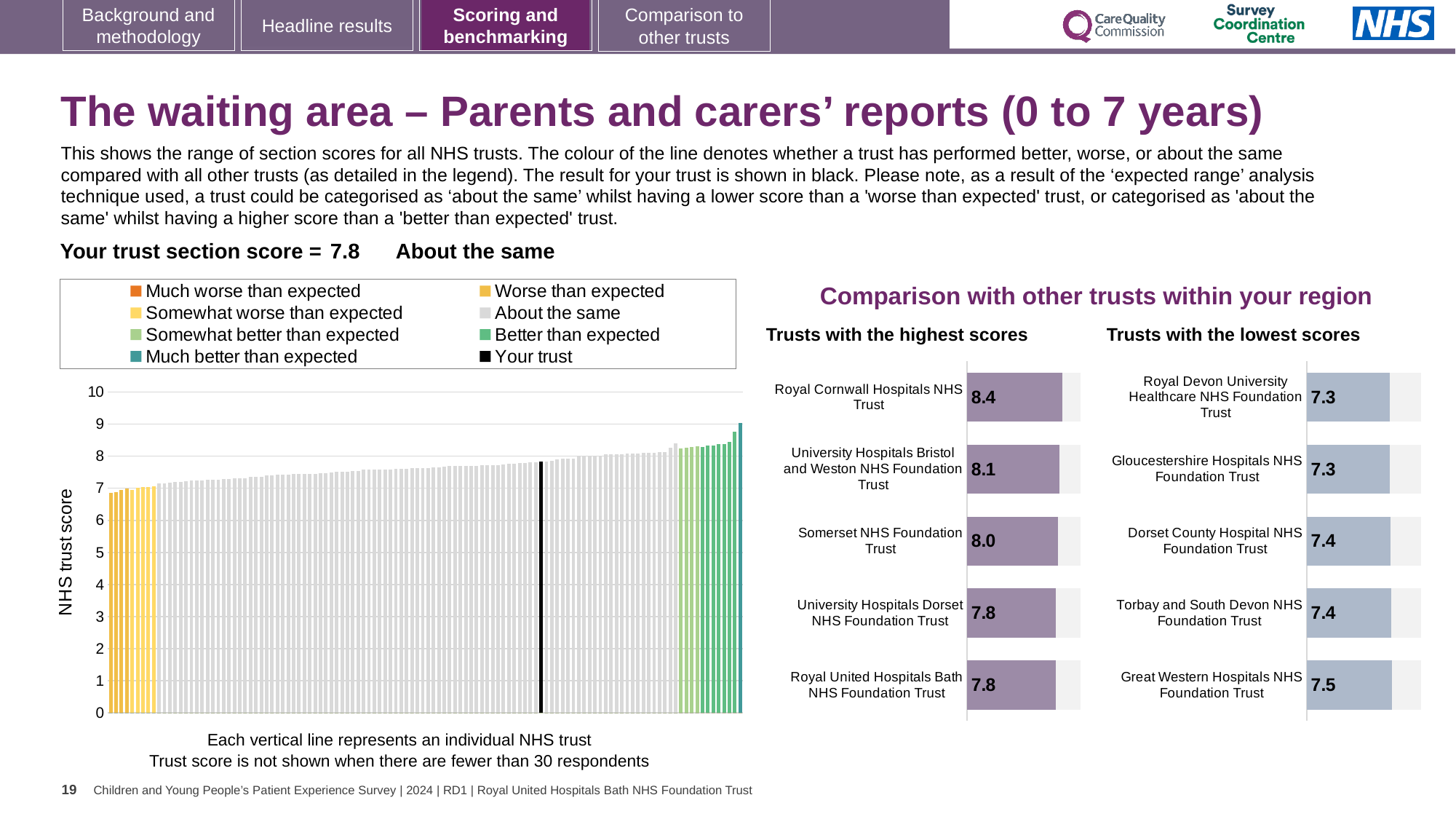
In the 'Trusts with the highest scores' chart, what is the score for Royal Cornwall Hospitals NHS Trust? 8.4 How many entries does the legend of the left-hand NHS trust score chart list? 8 In the 'Trusts with the lowest scores' chart, which has the larger score: Dorset County Hospital NHS Foundation Trust or Gloucestershire Hospitals NHS Foundation Trust? Dorset County Hospital NHS Foundation Trust In the 'Trusts with the highest scores' chart, what is the score for Somerset NHS Foundation Trust? 8.0 In the 'Trusts with the lowest scores' chart, what is the score for Great Western Hospitals NHS Foundation Trust? 7.5 In the left-hand NHS trust score chart, is the value of the lowest bar greater or less than 6? greater In the 'Trusts with the lowest scores' chart, which trust has the highest score? Great Western Hospitals NHS Foundation Trust In the 'Trusts with the highest scores' chart, what is the difference between the scores of Royal Cornwall Hospitals NHS Trust and Royal United Hospitals Bath NHS Foundation Trust? 0.6 In the 'Trusts with the lowest scores' chart, what is the difference between the scores of Great Western Hospitals NHS Foundation Trust and Royal Devon University Healthcare NHS Foundation Trust? 0.2 What kind of chart is the large chart on the left showing NHS trust scores? Bar chart In the 'Trusts with the highest scores' chart, which trust has the highest score? Royal Cornwall Hospitals NHS Trust How many trusts are shown in the 'Trusts with the highest scores' chart? 5